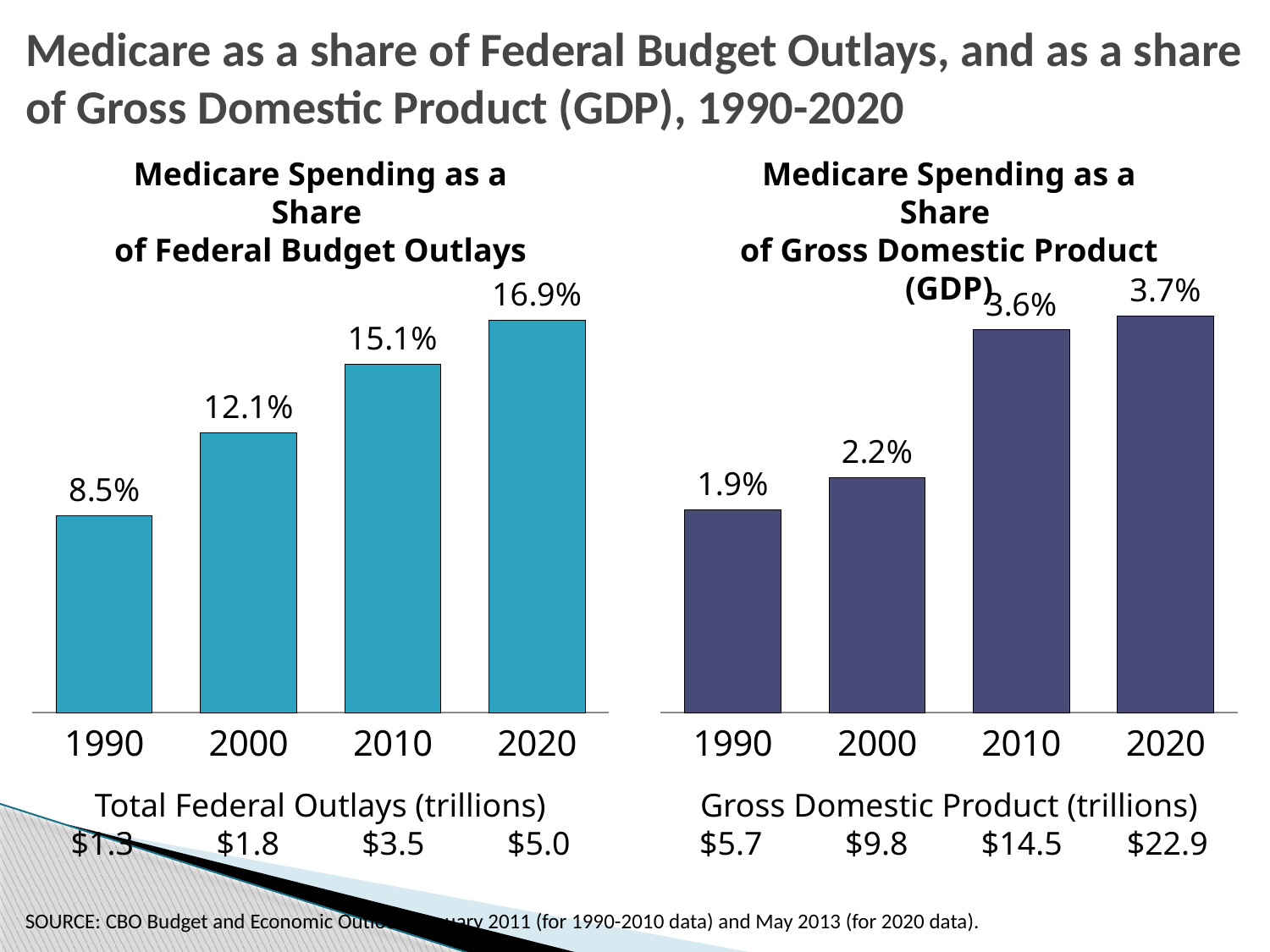
In the 'Medicare Spending as a Share of Federal Budget Outlays' chart, what is the value for 2010? 15.1% In the 'Medicare Spending as a Share of Federal Budget Outlays' chart, what is the value for 1990? 8.5% In the 'Medicare Spending as a Share of Gross Domestic Product (GDP)' chart, do the values rise or fall from 1990 to 2020? Rise In the 'Medicare Spending as a Share of Gross Domestic Product (GDP)' chart, what is the value for 2000? 2.2% In the 'Medicare Spending as a Share of Gross Domestic Product (GDP)' chart, what is the difference between the 2010 and 2000 values? 1.4% In the 'Medicare Spending as a Share of Federal Budget Outlays' chart, which is larger, the value for 2000 or the value for 2010? 2010 In the 'Medicare Spending as a Share of Federal Budget Outlays' chart, what is the difference between the 2020 and 1990 values? 8.4% In the 'Medicare Spending as a Share of Federal Budget Outlays' chart, which year has the highest value? 2020 In the 'Medicare Spending as a Share of Gross Domestic Product (GDP)' chart, which year has the lowest value? 1990 What kind of chart is the 'Medicare Spending as a Share of Federal Budget Outlays' chart? Bar chart What colour are the bars in the 'Medicare Spending as a Share of Gross Domestic Product (GDP)' chart? Dark blue How many years are shown in the 'Medicare Spending as a Share of Gross Domestic Product (GDP)' chart? 4